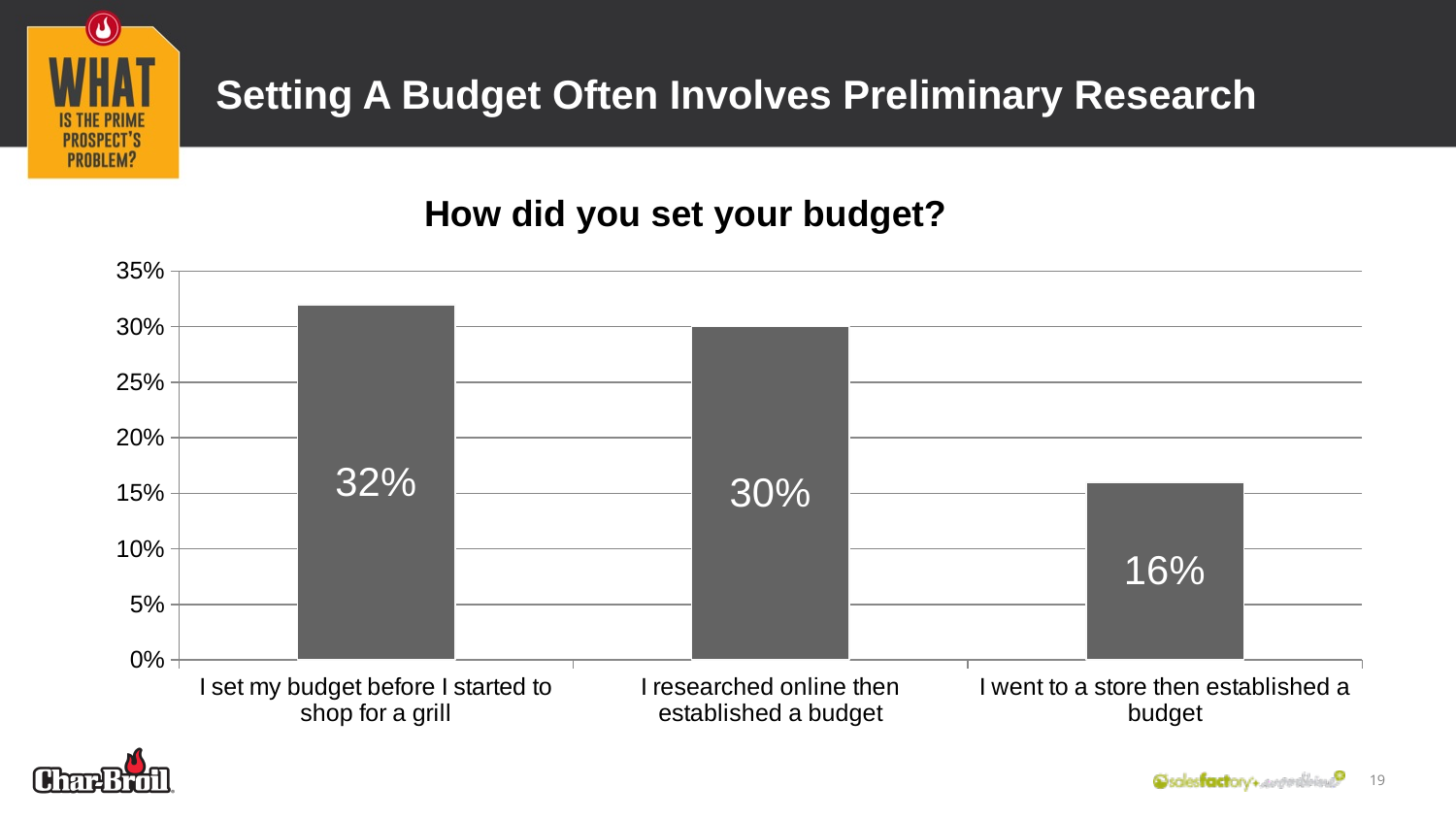
What kind of chart is shown on the slide? Bar chart What percentage of respondents went to a store then established a budget? 16% What is the difference between the highest and lowest values on the chart? 16 percentage points Is the value for "I went to a store then established a budget" greater or less than 20%? less What is the value for "I researched online then established a budget"? 30% What percentage of respondents said they set their budget before they started to shop for a grill? 32% Which response has the highest percentage? I set my budget before I started to shop for a grill What is the difference in percentage points between "I researched online then established a budget" and "I went to a store then established a budget"? 14 percentage points Which response has the lowest percentage? I went to a store then established a budget Which is larger: the value for "I researched online then established a budget" or the value for "I went to a store then established a budget"? I researched online then established a budget How many response categories are shown on the chart? 3 What is the title of the chart? How did you set your budget?